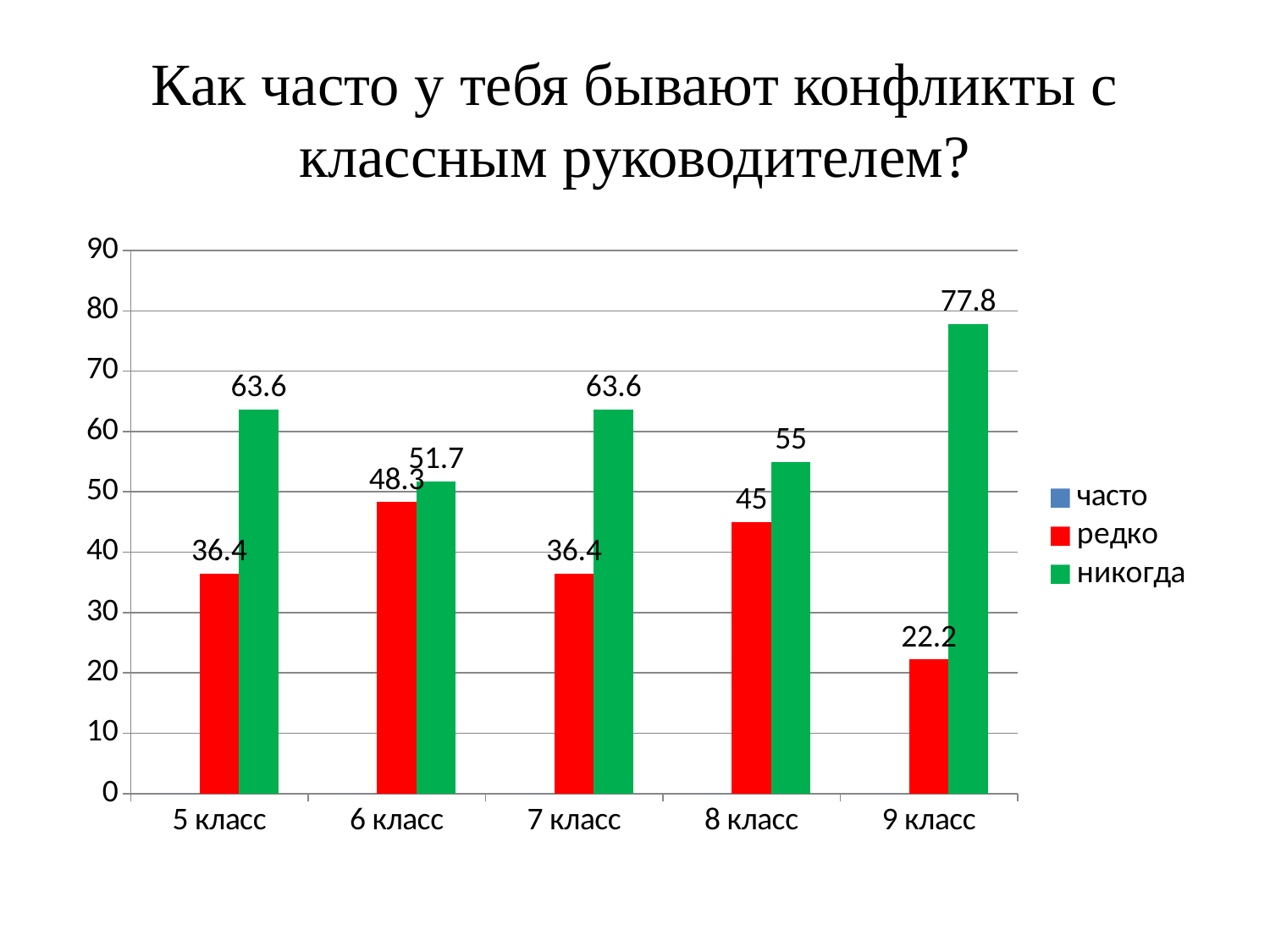
What is the value for "редко" in 6 класс? 48.3 What is the value for "никогда" in 8 класс? 55 What kind of chart is shown on the slide? bar chart Which colour represents the series "редко" in the legend? red Which class has the highest value for "никогда"? 9 класс How many series does the legend list? 3 What is the difference between "никогда" and "редко" in 9 класс? 55.6 What is the value for "редко" in 9 класс? 22.2 Which class has the lowest value for "редко"? 9 класс Which is larger in 6 класс: "редко" or "никогда"? никогда What is the value for "никогда" in 9 класс? 77.8 How many classes (categories) are shown on the x axis? 5